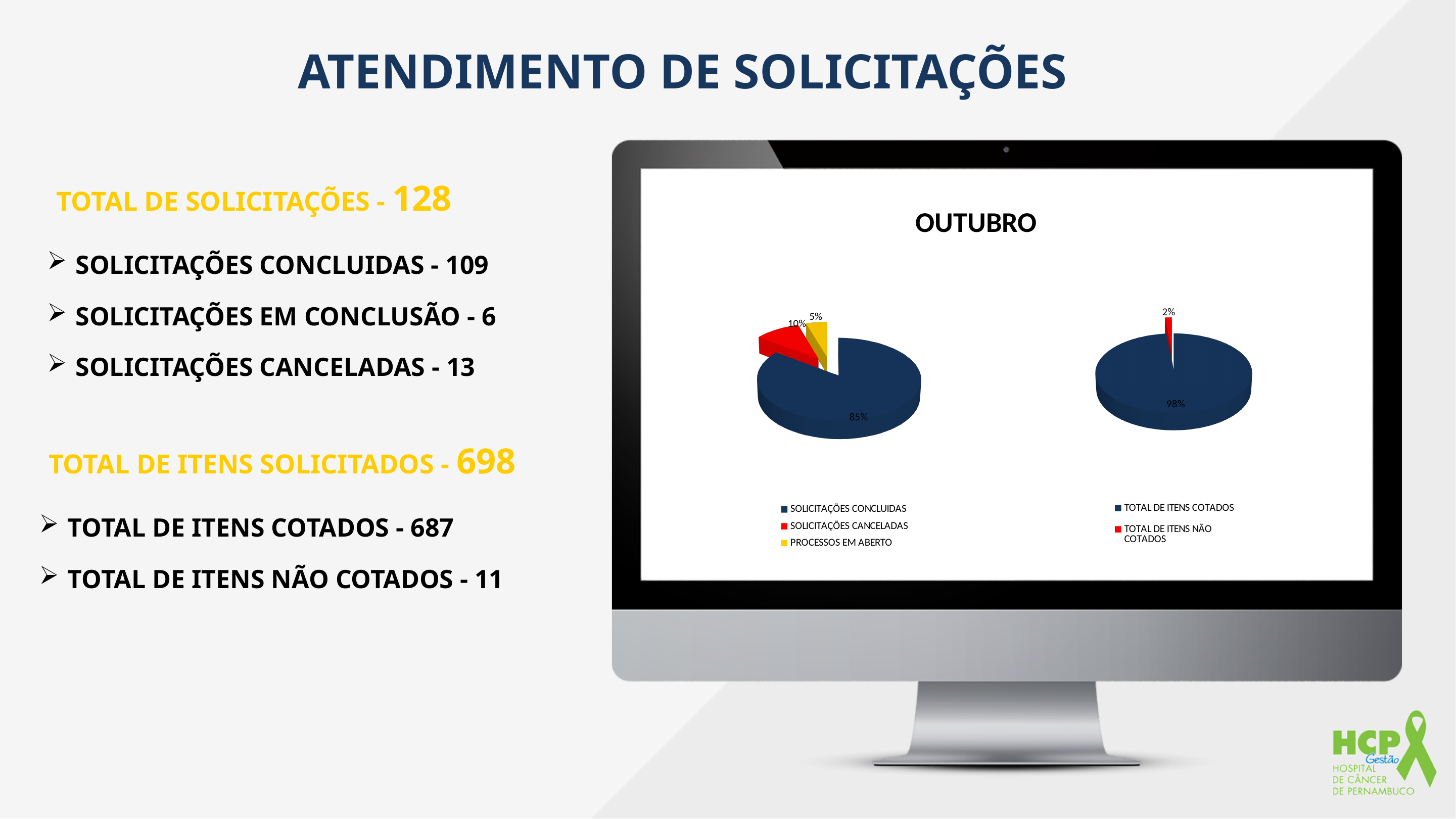
How many slices does the left pie chart have? 3 On the right pie chart, what share is labelled for TOTAL DE ITENS COTADOS? 98% On the right pie chart, what share is labelled for TOTAL DE ITENS NÃO COTADOS? 2% On the left pie chart, what is the difference between the shares for SOLICITAÇÕES CANCELADAS and PROCESSOS EM ABERTO? 5% On the left pie chart, which category has the smallest slice? PROCESSOS EM ABERTO On the right pie chart, which category has the smallest slice? TOTAL DE ITENS NÃO COTADOS On the left pie chart, what share is labelled for PROCESSOS EM ABERTO? 5% How many entries does the legend of the right pie chart list? 2 On the left pie chart, which category has the largest slice? SOLICITAÇÕES CONCLUIDAS On the left pie chart, what share is labelled for SOLICITAÇÕES CANCELADAS? 10% What type of chart is shown on the right side of the monitor? Pie chart On the left pie chart, what share is labelled for SOLICITAÇÕES CONCLUIDAS? 85%